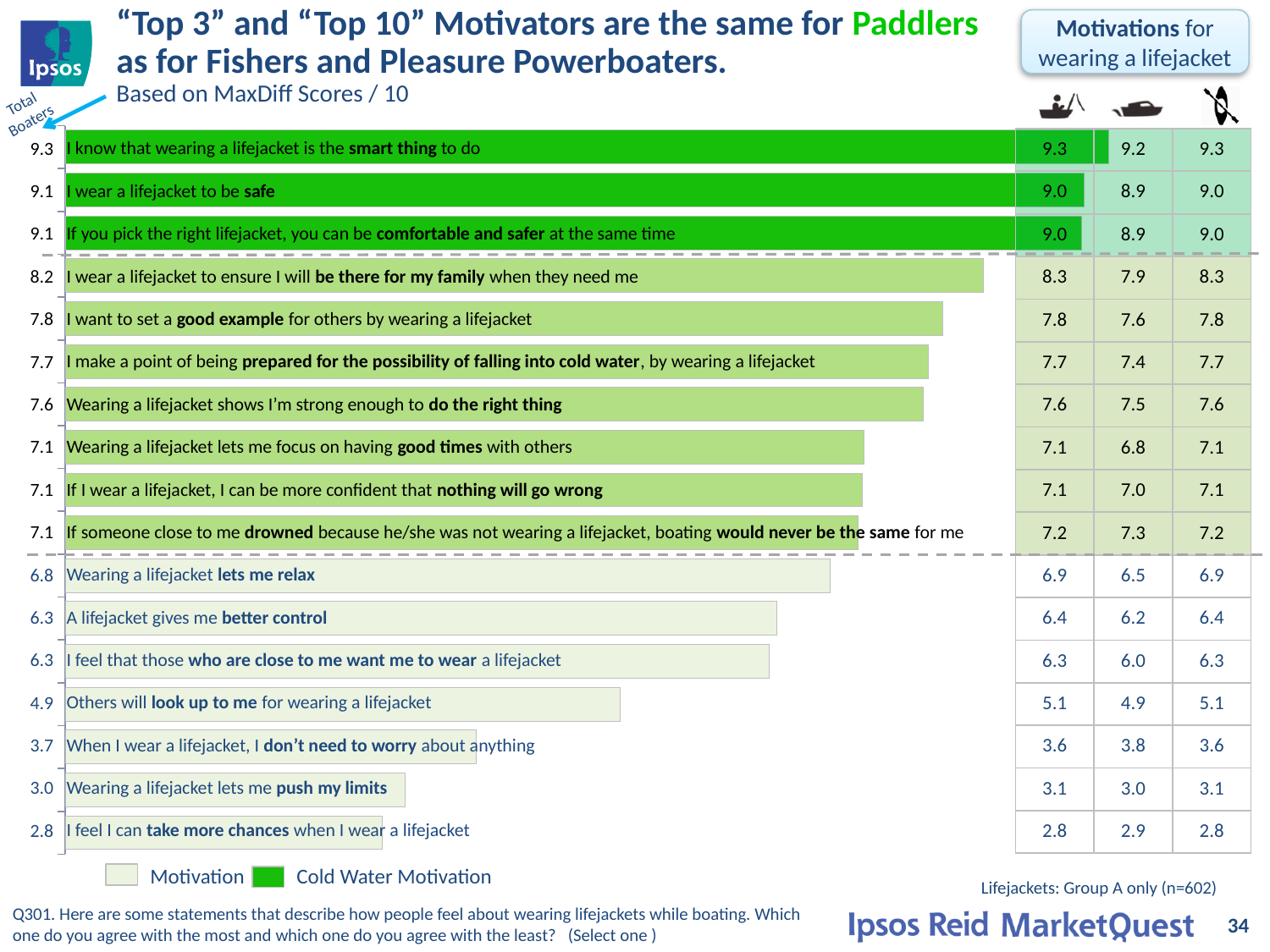
Which statement has the lowest Total Boaters score in the bar chart? I feel I can take more chances when I wear a lifejacket What are the two entries in the chart legend? Motivation; Cold Water Motivation Which statement has the highest Total Boaters score in the bar chart? I know that wearing a lifejacket is the smart thing to do How many statements (bars) are shown in the bar chart? 17 What is the Total Boaters score shown for "Wearing a lifejacket lets me relax"? 6.8 What is the Total Boaters score for "I want to set a good example for others by wearing a lifejacket"? 7.8 What is the difference between the highest Total Boaters score (9.3) and the lowest (2.8)? 6.5 Which has the larger Total Boaters score: "Others will look up to me for wearing a lifejacket" or "When I wear a lifejacket, I don't need to worry about anything"? Others will look up to me for wearing a lifejacket What is the difference between the Total Boaters scores for "A lifejacket gives me better control" and "Wearing a lifejacket lets me push my limits"? 3.3 What is the Total Boaters MaxDiff score for the statement "I wear a lifejacket to be safe"? 9.1 How many entries does the chart legend list? 2 What kind of chart is used to show the MaxDiff scores? Bar chart